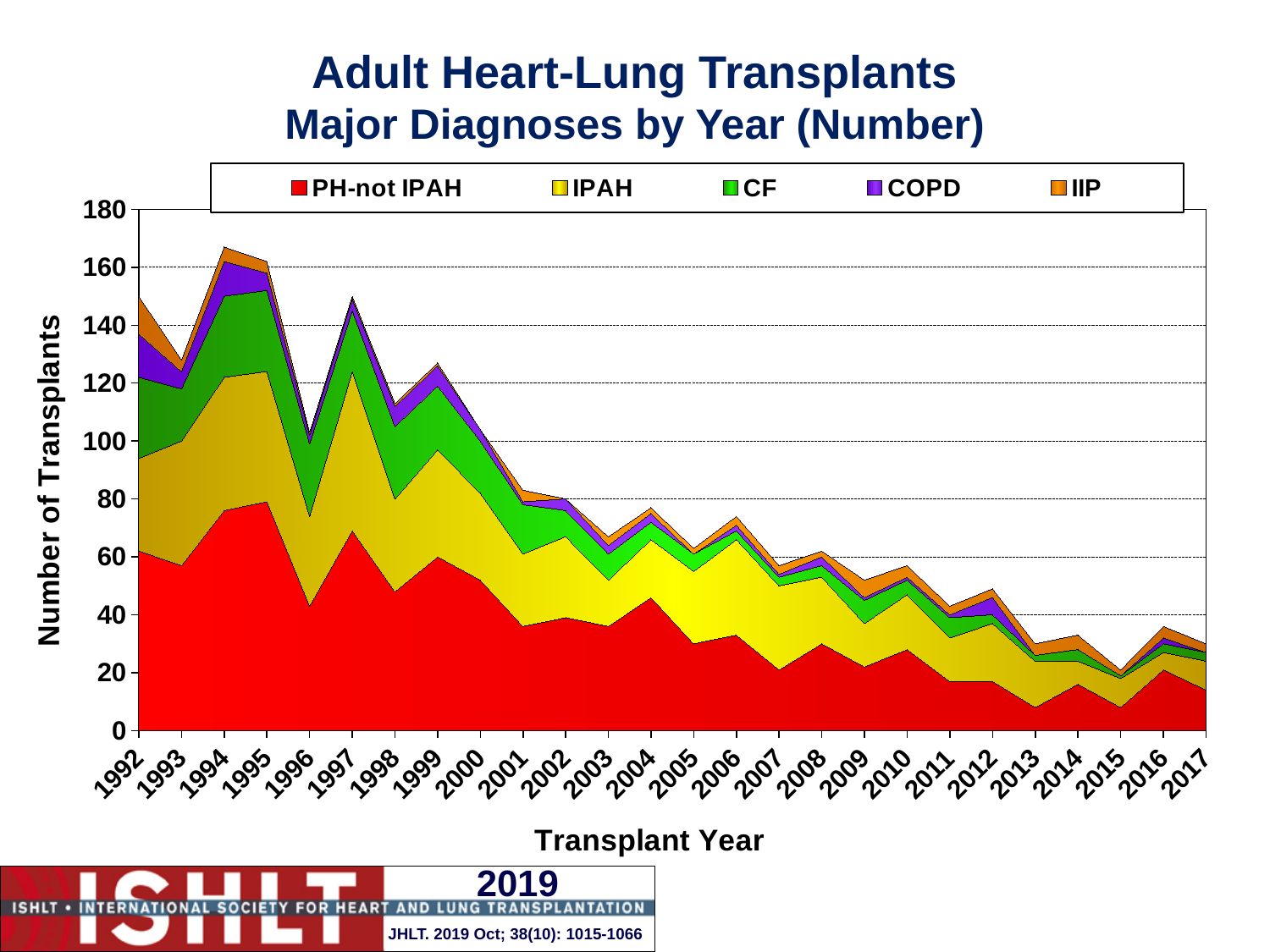
Is the total number of transplants in 2017 greater or less than 40? less In which year is the total number of transplants lowest? 2015 How many series does the legend list? 5 Is the number of PH-not IPAH transplants in 2013 greater or less than 20? less In which year is the total number of transplants highest? 1994 What kind of chart is shown on the slide? Stacked area chart Which year has a larger total number of transplants, 1994 or 1996? 1994 Which colour represents the PH-not IPAH series in the legend? Red How many transplant years are plotted along the x axis? 26 Overall, do the total number of heart-lung transplants rise or fall from 1992 to 2017? Fall Is the total number of transplants in 1992 greater or less than 140? greater